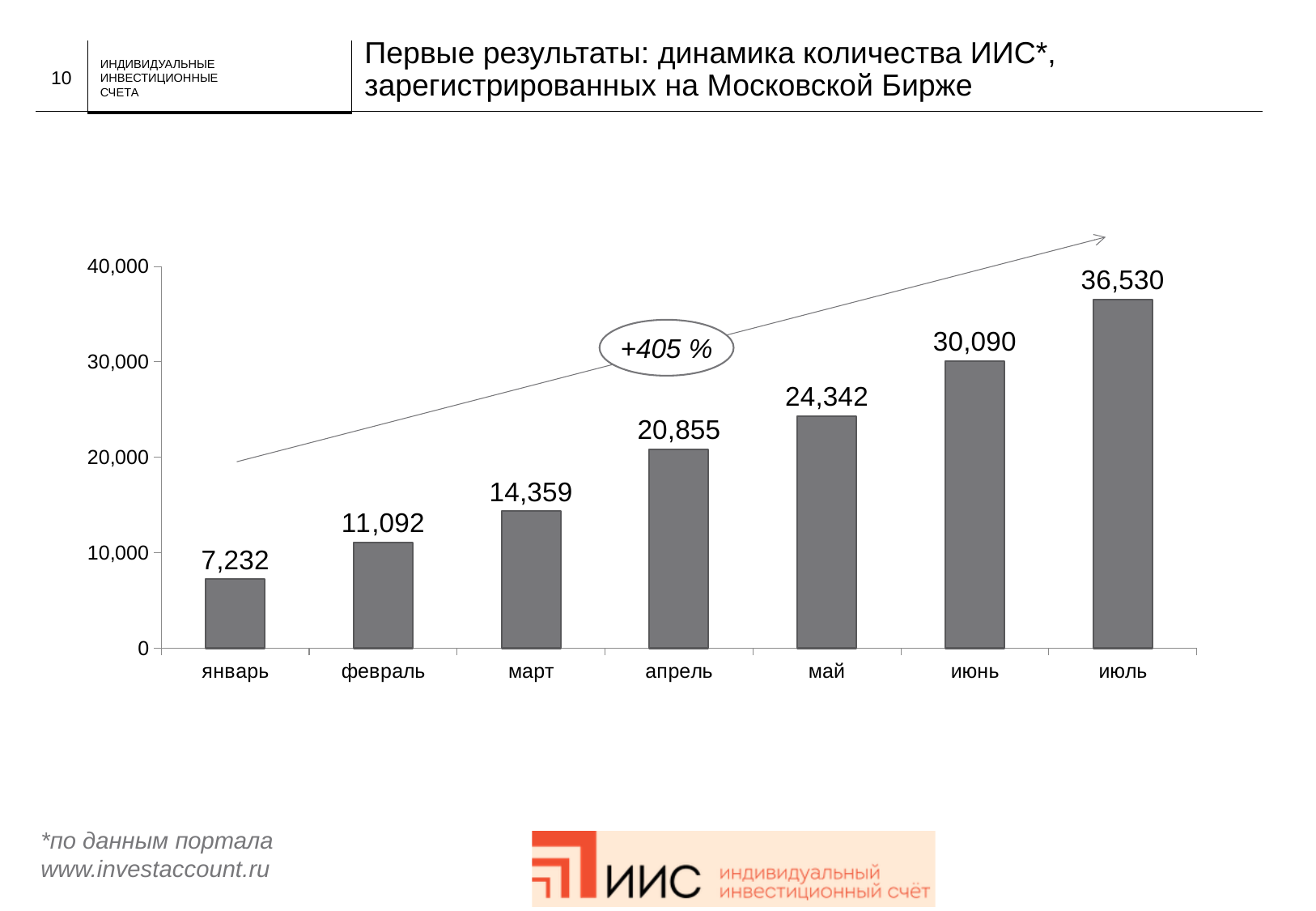
How many months are shown on the x axis? 7 What is the difference between the values for июль and январь? 29,298 Which is larger, the value for март or the value for февраль? март Do the values rise or fall from январь to июль? rise Which month has the highest value? июль Which month has the lowest value? январь What is the value for январь? 7,232 Is the value for май greater or less than 20,000? greater What kind of chart is shown on the slide? bar chart What is the difference between the values for май and апрель? 3,487 What is the value for июнь? 30,090 What is the value for апрель? 20,855